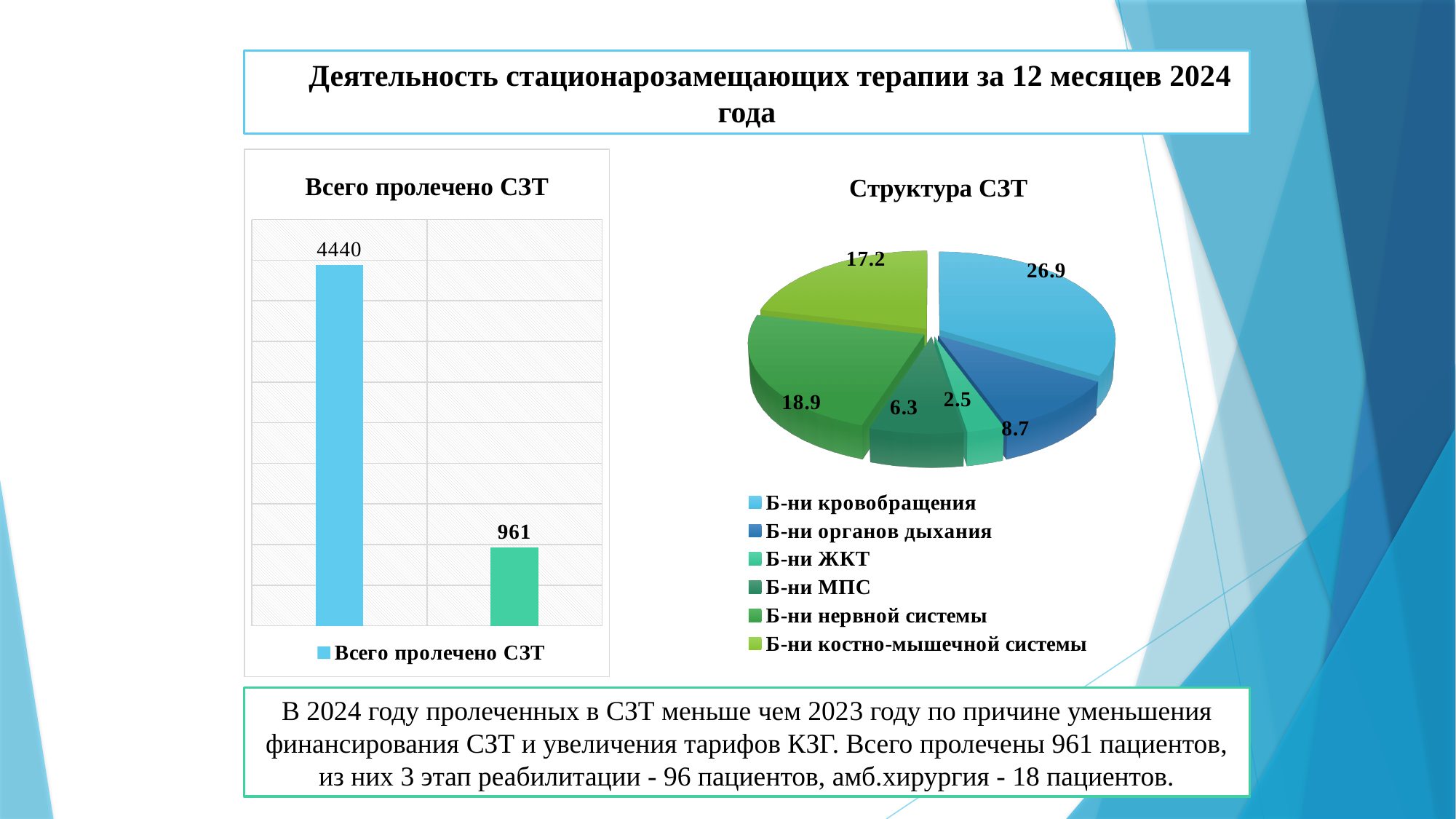
In the pie chart titled "Структура СЗТ", what is the value for "Б-ни ЖКТ"? 2.5 In the pie chart titled "Структура СЗТ", what is the value for "Б-ни кровобращения"? 26.9 In the chart titled "Всего пролечено СЗТ", what is the value of the left (taller) bar? 4440 In the pie chart titled "Структура СЗТ", which category has the largest slice? Б-ни кровобращения How many categories does the legend of the pie chart "Структура СЗТ" list? 6 In the chart titled "Всего пролечено СЗТ", how many bars are plotted? 2 In the pie chart titled "Структура СЗТ", which is larger: "Б-ни нервной системы" or "Б-ни костно-мышечной системы"? Б-ни нервной системы In the chart titled "Всего пролечено СЗТ", do the values rise or fall from left to right? Fall In the pie chart titled "Структура СЗТ", which category has the smallest slice? Б-ни ЖКТ What kind of chart is "Всего пролечено СЗТ"? Bar chart In the chart titled "Всего пролечено СЗТ", what is the difference between the two bars? 3479 In the chart titled "Всего пролечено СЗТ", what is the value of the right (shorter) bar? 961